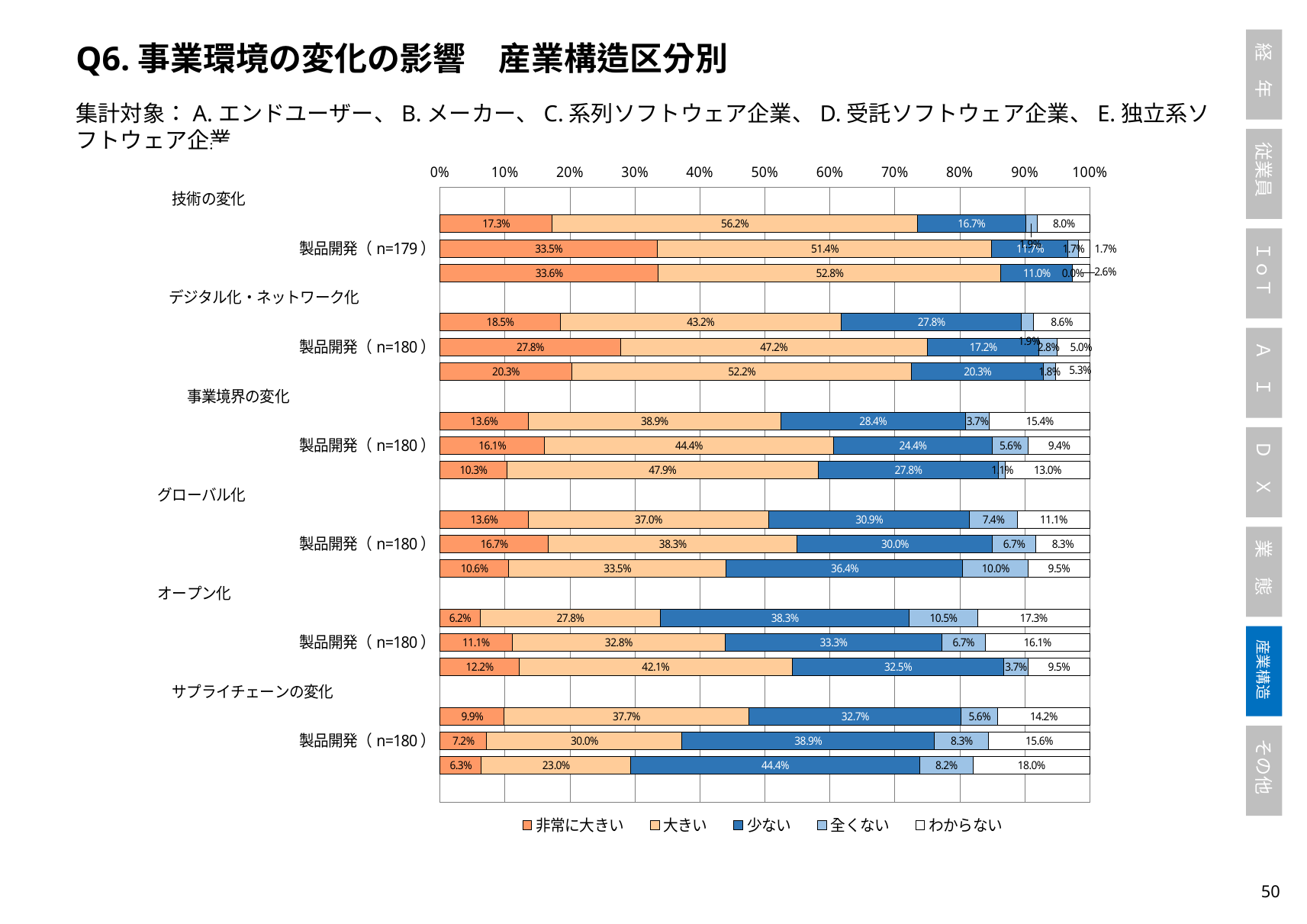
What is the 大きい value for 製品開発 under デジタル化・ネットワーク化? 47.2% What is the sample size (n) shown for 製品開発 under 技術の変化? 179 How many series does the legend list? 5 How many category groups (e.g. 技術の変化, グローバル化) are shown on the chart? 6 What is the 非常に大きい value for 製品開発 under 技術の変化? 33.5% Among the 製品開発 bars, which category has the lowest 非常に大きい value? サプライチェーンの変化 For the 製品開発 bars, is the 少ない value larger under グローバル化 or under オープン化? オープン化 Among the 製品開発 bars, which category has the highest 非常に大きい value? 技術の変化 What kind of chart is shown on the slide? bar chart What is the わからない value for 製品開発 under オープン化? 16.1% What is the 少ない value for 製品開発 under サプライチェーンの変化? 38.9% For 製品開発 under 事業境界の変化, what is the difference between the 大きい value and the 非常に大きい value? 28.3 percentage points